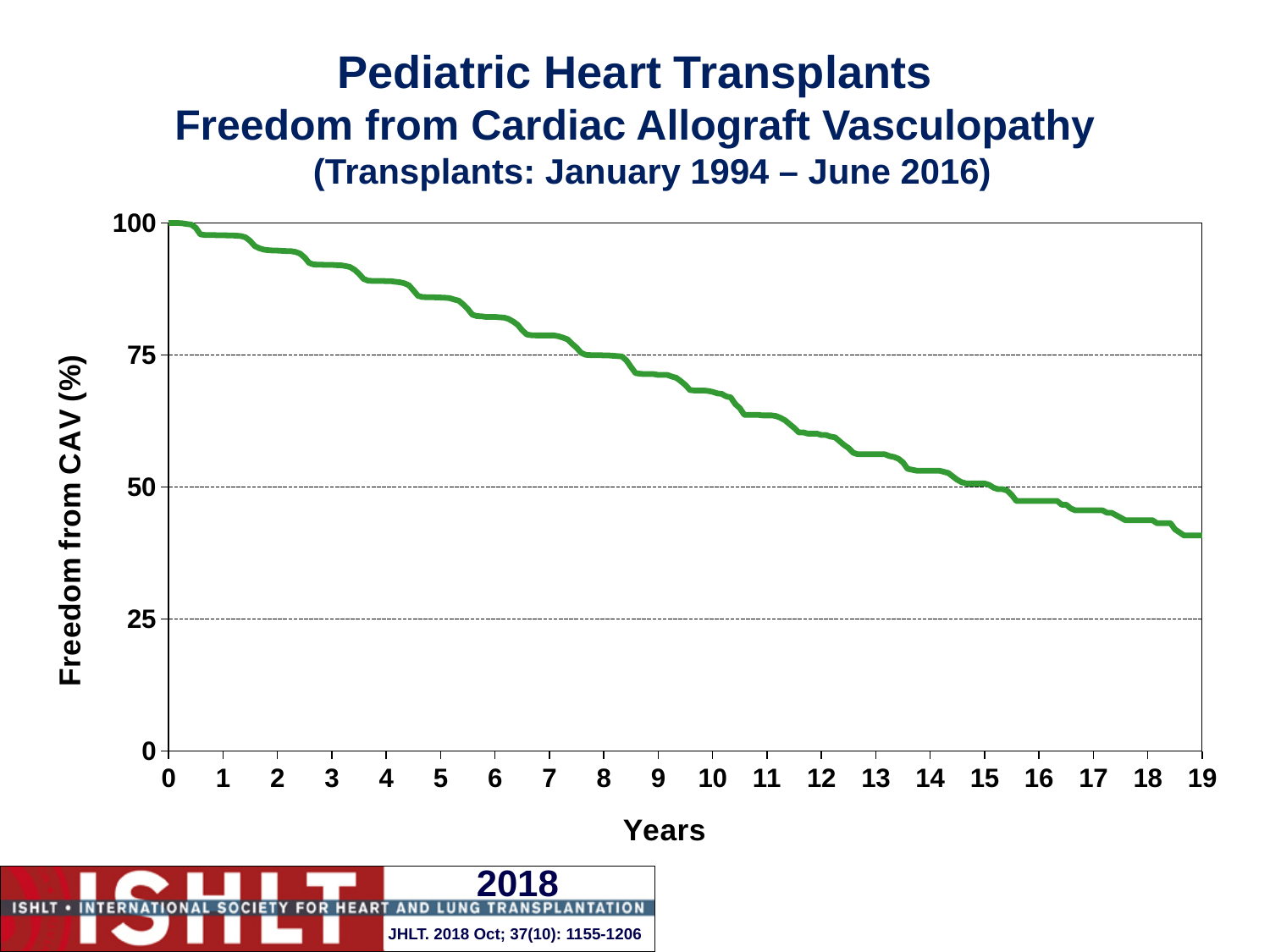
Is the freedom from CAV value at year 5 greater or less than 75? greater Does freedom from CAV rise or fall as the years increase? fall Is the freedom from CAV value at year 12 greater or less than 75? less What is the freedom from CAV value at year 0? 100 What transplant date range is given in the chart title? January 1994 – June 2016 Is the freedom from CAV value at year 10 greater or less than 50? greater What kind of chart is shown on the slide? line chart At which year is freedom from CAV highest? 0 At which year is freedom from CAV lowest? 19 What is the label of the y axis? Freedom from CAV (%)